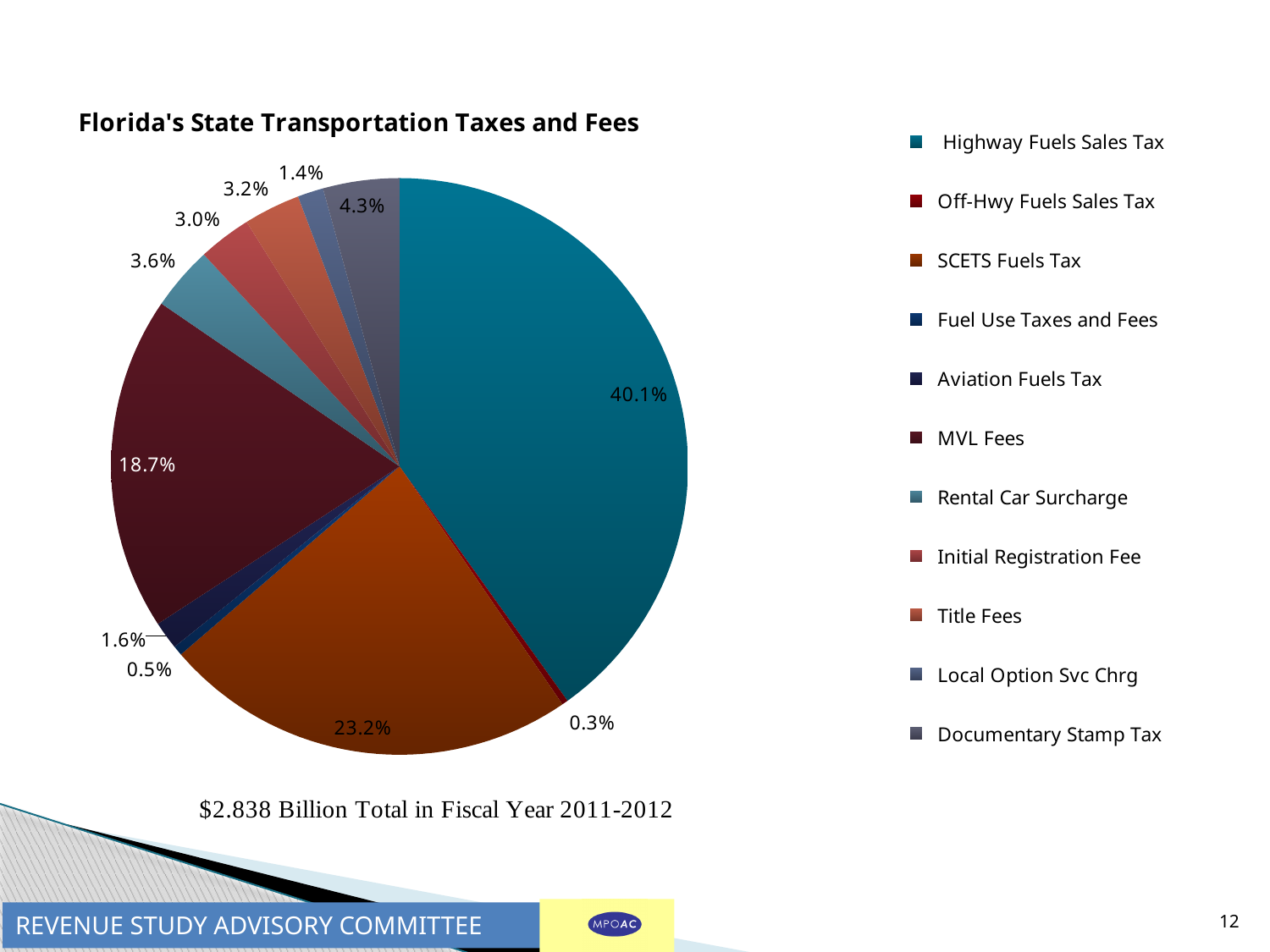
How many categories does the legend list? 11 What share of the pie is Documentary Stamp Tax? 4.3% What is the difference in percentage points between Highway Fuels Sales Tax and SCETS Fuels Tax? 16.9 What is the title of the chart? Florida's State Transportation Taxes and Fees Which category has the largest slice of the pie? Highway Fuels Sales Tax What share of the pie is SCETS Fuels Tax? 23.2% What total dollar amount does the slide state for Fiscal Year 2011-2012? $2.838 Billion What share of the pie is MVL Fees? 18.7% Which is larger, the share for Rental Car Surcharge or the share for Title Fees? Rental Car Surcharge Which category has the smallest slice of the pie? Off-Hwy Fuels Sales Tax What kind of chart is shown on the slide? pie chart